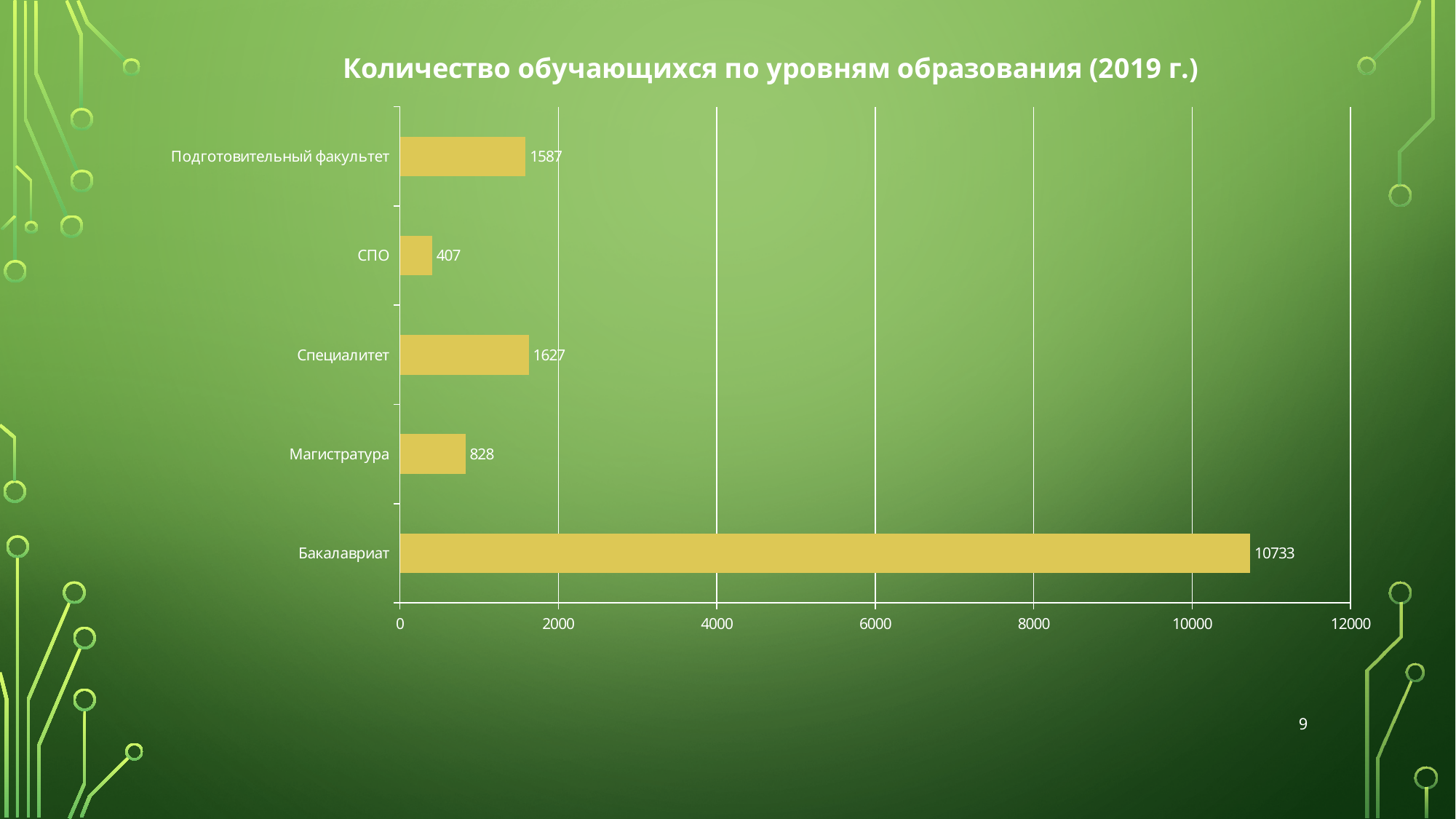
What is the value for Бакалавриат? 10733 What kind of chart is shown on the slide? bar chart How many categories are shown in the chart? 5 What is the value for СПО? 407 What is the value for Магистратура? 828 What is the value for Подготовительный факультет? 1587 What is the difference between the values for Магистратура and СПО? 421 What is the difference between the values for Специалитет and Подготовительный факультет? 40 Which category has the lowest value? СПО Which category has the highest value? Бакалавриат Which is larger, the value for Специалитет or the value for Магистратура? Специалитет Is the value for Бакалавриат greater or less than 10000? greater